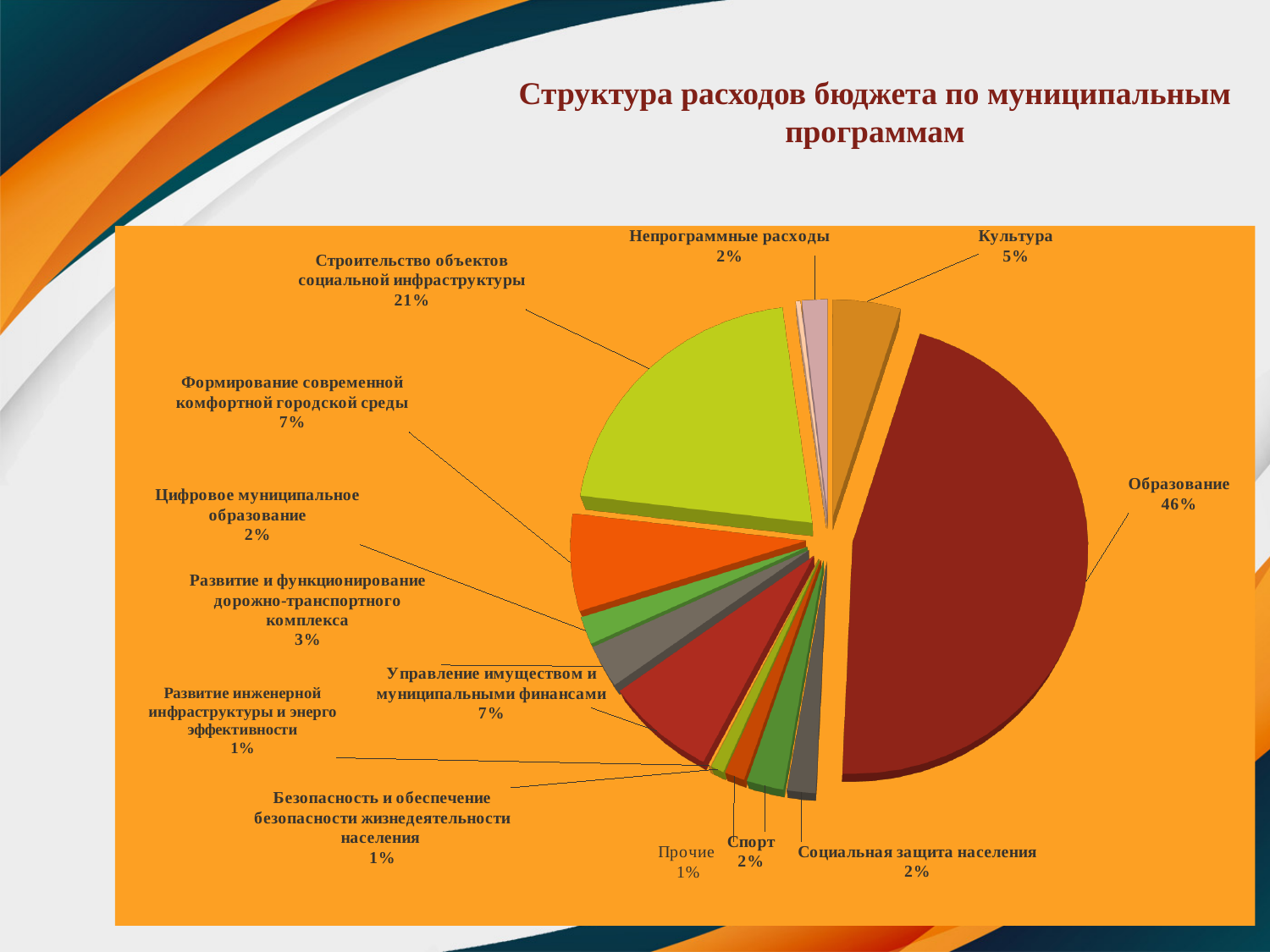
What percentage is labelled for Культура? 5% How many slices does the pie chart have? 14 What share is shown for Управление имуществом и муниципальными финансами? 7% What is the combined share of Формирование современной комфортной городской среды and Управление имуществом и муниципальными финансами? 14% What is the title of the chart on the slide? Структура расходов бюджета по муниципальным программам What type of chart is shown on the slide? pie chart What share is shown for Строительство объектов социальной инфраструктуры? 21% What percentage is shown for Развитие и функционирование дорожно-транспортного комплекса? 3% Which has a larger share, Культура or Спорт? Культура Which category has the largest share of the pie? Образование What share of budget expenditure goes to Образование? 46% What is the difference in percentage points between Образование and Строительство объектов социальной инфраструктуры? 25